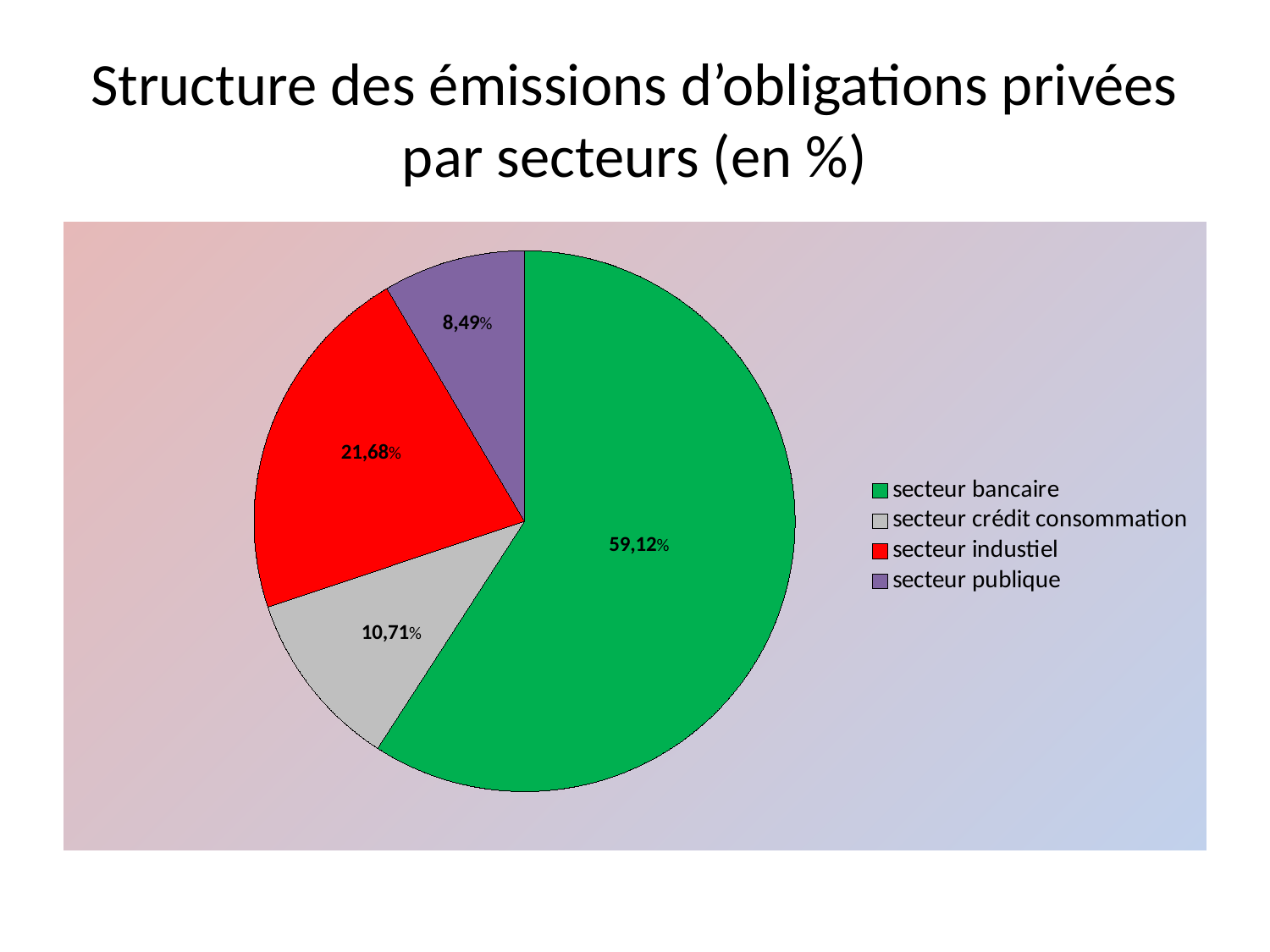
What is the value for secteur industiel? 21,68% What is the value for secteur crédit consommation? 10,71% Which sector has the largest share of the pie? secteur bancaire How many slices does the pie chart have? 4 What kind of chart is shown on the slide? pie chart What is the value for secteur publique? 8,49% Which is larger, secteur industiel or secteur crédit consommation? secteur industiel What is the value for secteur bancaire? 59,12% What is the difference between the values for secteur bancaire and secteur industiel? 37,44% Which sector has the smallest share of the pie? secteur publique What colour is the slice for secteur industiel? red What is the title of the slide? Structure des émissions d'obligations privées par secteurs (en %)